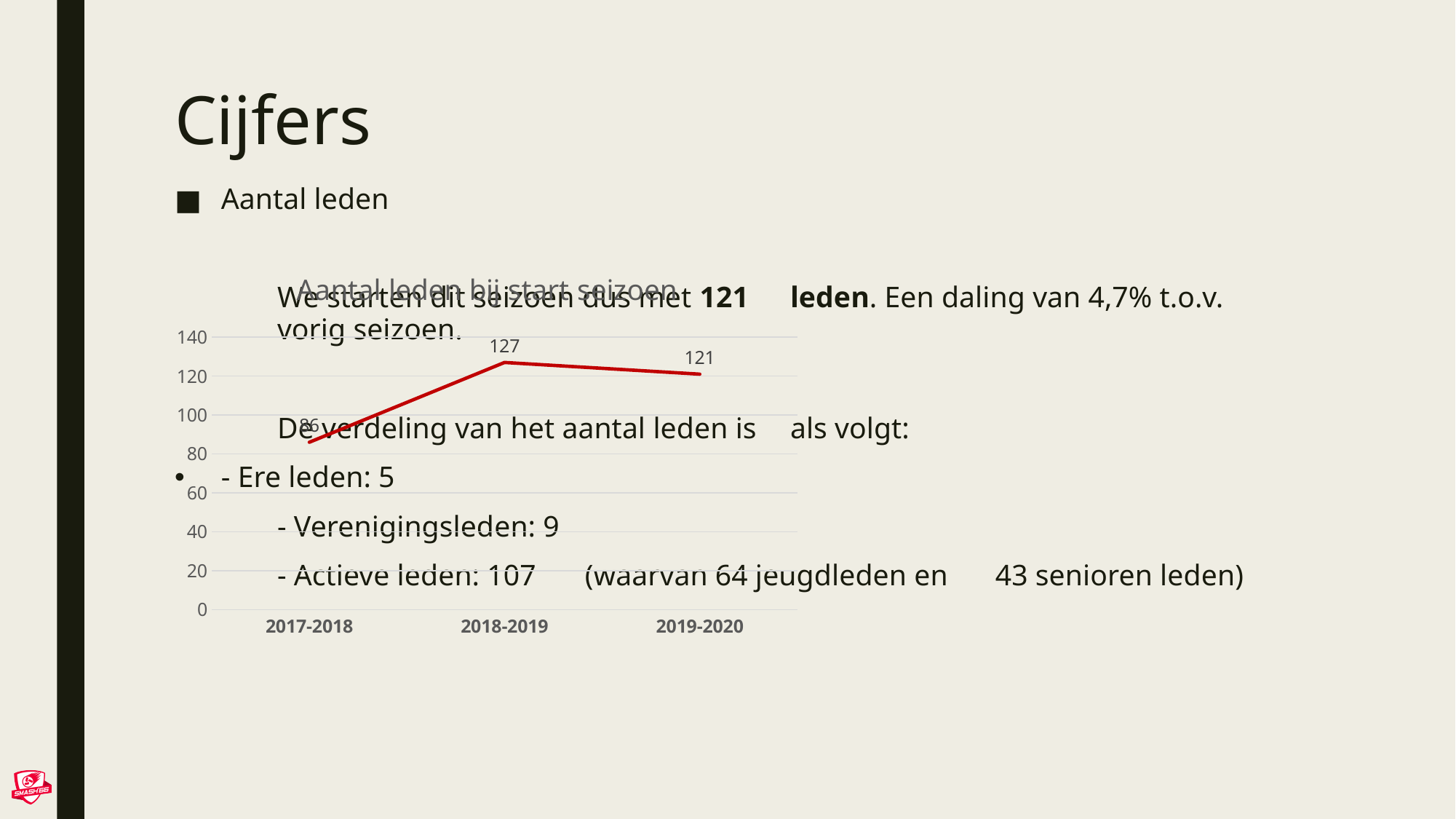
Which is larger, the value for 2018-2019 or the value for 2019-2020? 2018-2019 Which season has the highest value on the chart? 2018-2019 What is the difference between the values for 2018-2019 and 2019-2020? 6 Is the value for 2017-2018 greater or less than 100? less How many seasons are plotted on the x axis? 3 What kind of chart is shown on the slide? line chart What is the number of members shown for 2019-2020? 121 What is the title of the chart? Aantal leden bij start seizoen Does the line rise or fall from 2018-2019 to 2019-2020? fall What colour is the line in the chart? red What is the number of members shown for 2018-2019? 127 Which season has the lowest value on the chart? 2017-2018